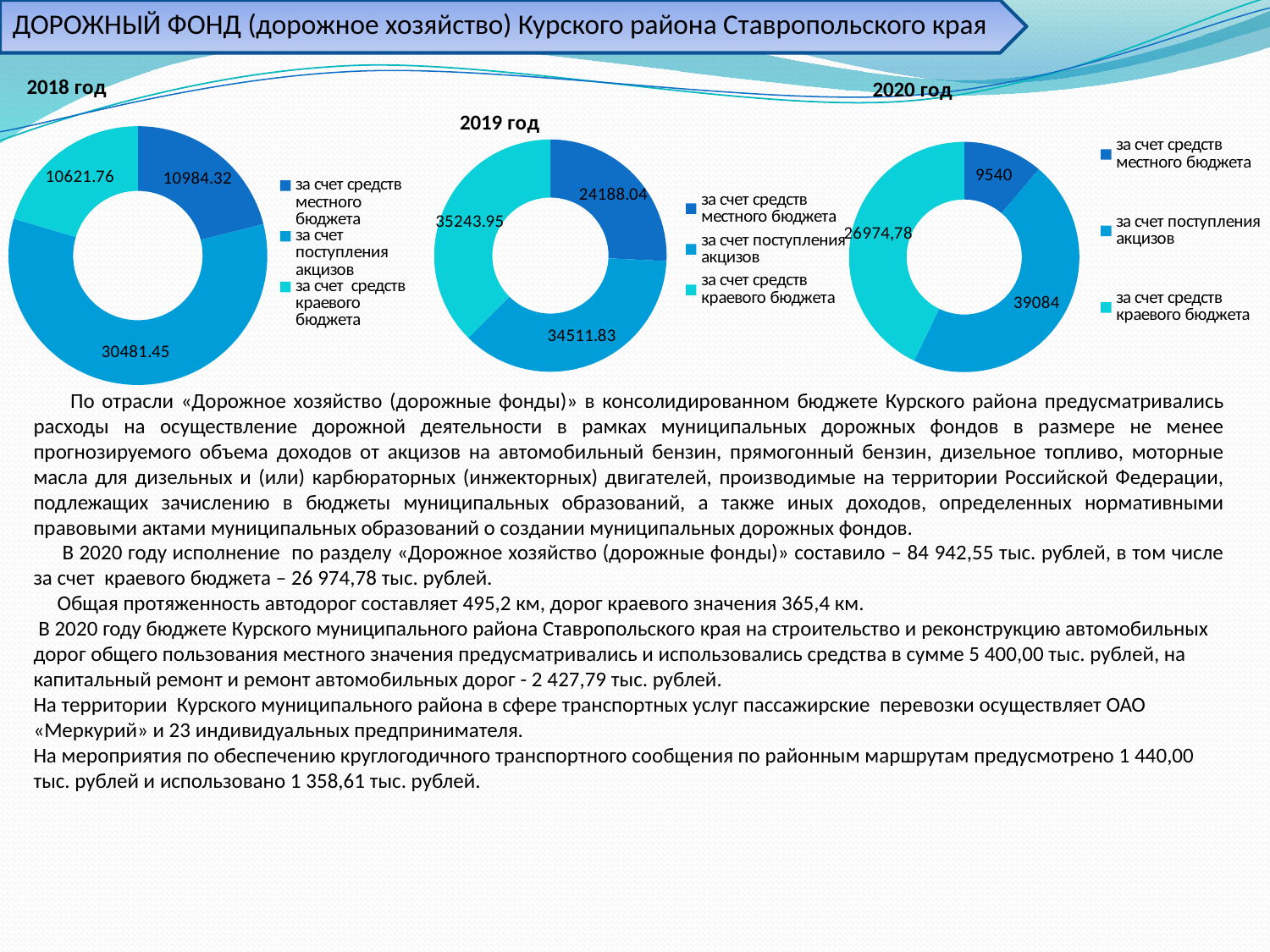
What is the total of all three values on the 2018 год chart? 52087.53 On the 2019 год chart, what is the value for «за счет средств краевого бюджета»? 35243.95 On the 2018 год chart, what is the value for «за счет средств местного бюджета»? 10984.32 What type of chart is used for 2018 год? Doughnut chart How many categories does the 2019 год chart show? 3 On the 2018 год chart, what is the difference between «за счет поступления акцизов» and «за счет средств местного бюджета»? 19497.13 On the 2020 год chart, what is the value for «за счет средств местного бюджета»? 9540 On the 2020 год chart, which category has the highest value? за счет поступления акцизов On the 2019 год chart, which category has the lowest value? за счет средств местного бюджета How many charts are shown on the slide? 3 On the 2020 год chart, which is larger: «за счет поступления акцизов» or «за счет средств краевого бюджета»? за счет поступления акцизов On the 2018 год chart, what is the value for «за счет поступления акцизов»? 30481.45